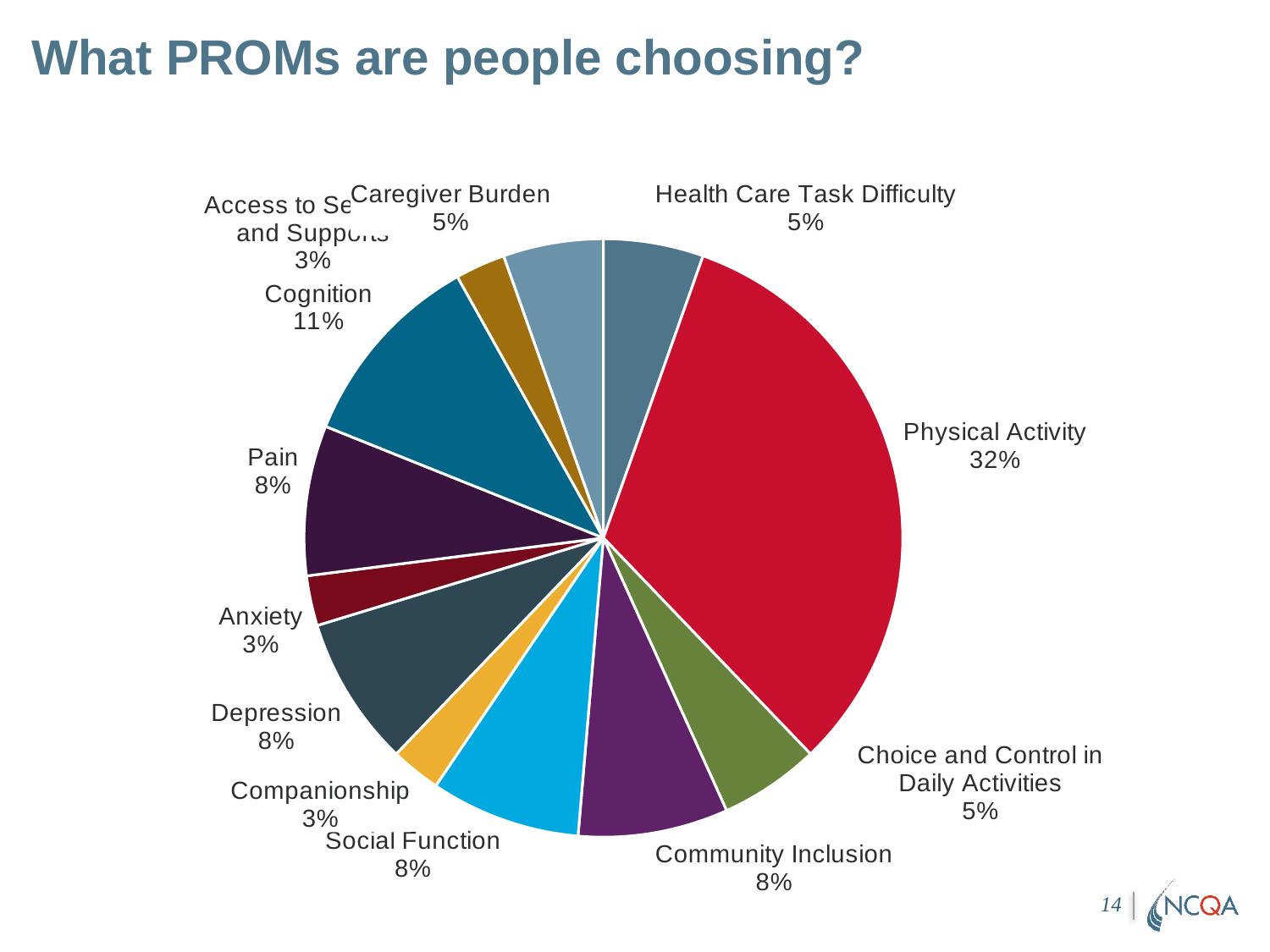
What kind of chart is shown on the slide? Pie chart What is the difference in percentage points between Physical Activity and Cognition? 21 percentage points What is the title of the chart on the slide? What PROMs are people choosing? What is the value shown for Cognition? 11% How many slices does the pie chart have? 12 What share of the pie does Physical Activity represent? 32% What is the value shown for Caregiver Burden? 5% Which is larger, the share for Cognition or the share for Pain? Cognition What is the difference in percentage points between Depression and Companionship? 5 percentage points Which category has the largest slice of the pie? Physical Activity What is the value shown for Community Inclusion? 8% What is the value shown for Anxiety? 3%